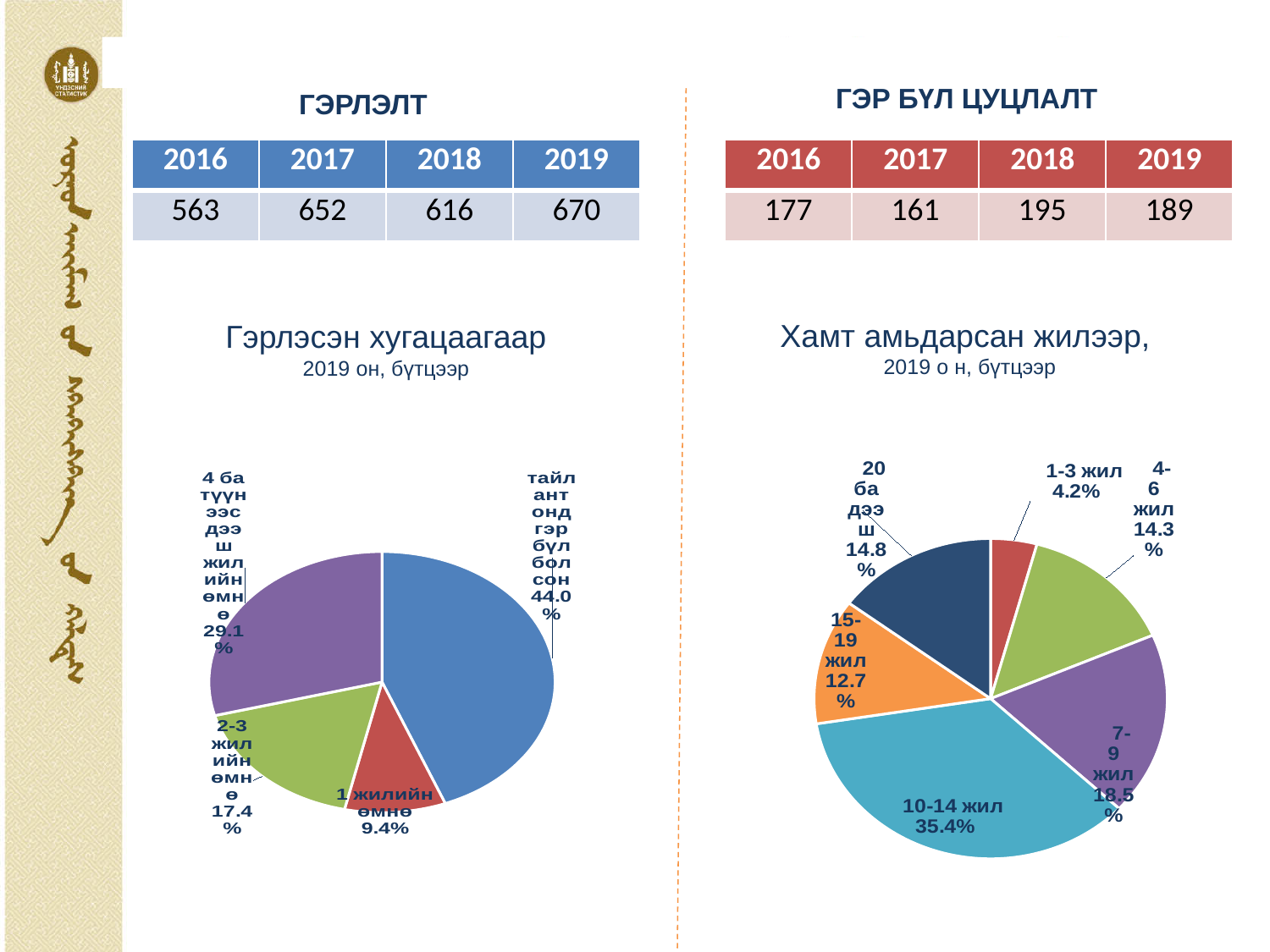
In the left pie chart (Гэрлэсэн хугацаагаар), what share is labelled for '1 жилийн өмнө'? 9.4% In the right pie chart (Хамт амьдарсан жилээр), how many slices does the pie have? 6 What type of chart is used for 'Хамт амьдарсан жилээр' on the right side of the slide? Pie chart In the left pie chart (Гэрлэсэн хугацаагаар), what share is labelled for 'тайлант онд гэр бүл болсон'? 44.0% In the left pie chart (Гэрлэсэн хугацаагаар), what is the difference between the shares for '4 ба түүнээс дээш жилийн өмнө' and '2-3 жилийн өмнө'? 11.7% In the right pie chart (Хамт амьдарсан жилээр), what share is labelled for '10-14 жил'? 35.4% In the right pie chart (Хамт амьдарсан жилээр), what share is labelled for '1-3 жил'? 4.2% In the left pie chart (Гэрлэсэн хугацаагаар), how many slices does the pie have? 4 In the left pie chart (Гэрлэсэн хугацаагаар), which category has the smallest slice? 1 жилийн өмнө In the right pie chart (Хамт амьдарсан жилээр), which category has the largest slice? 10-14 жил In the right pie chart (Хамт амьдарсан жилээр), which is larger: the share for '7-9 жил' or the share for '15-19 жил'? 7-9 жил In the left pie chart (Гэрлэсэн хугацаагаар), which category has the largest slice? тайлант онд гэр бүл болсон